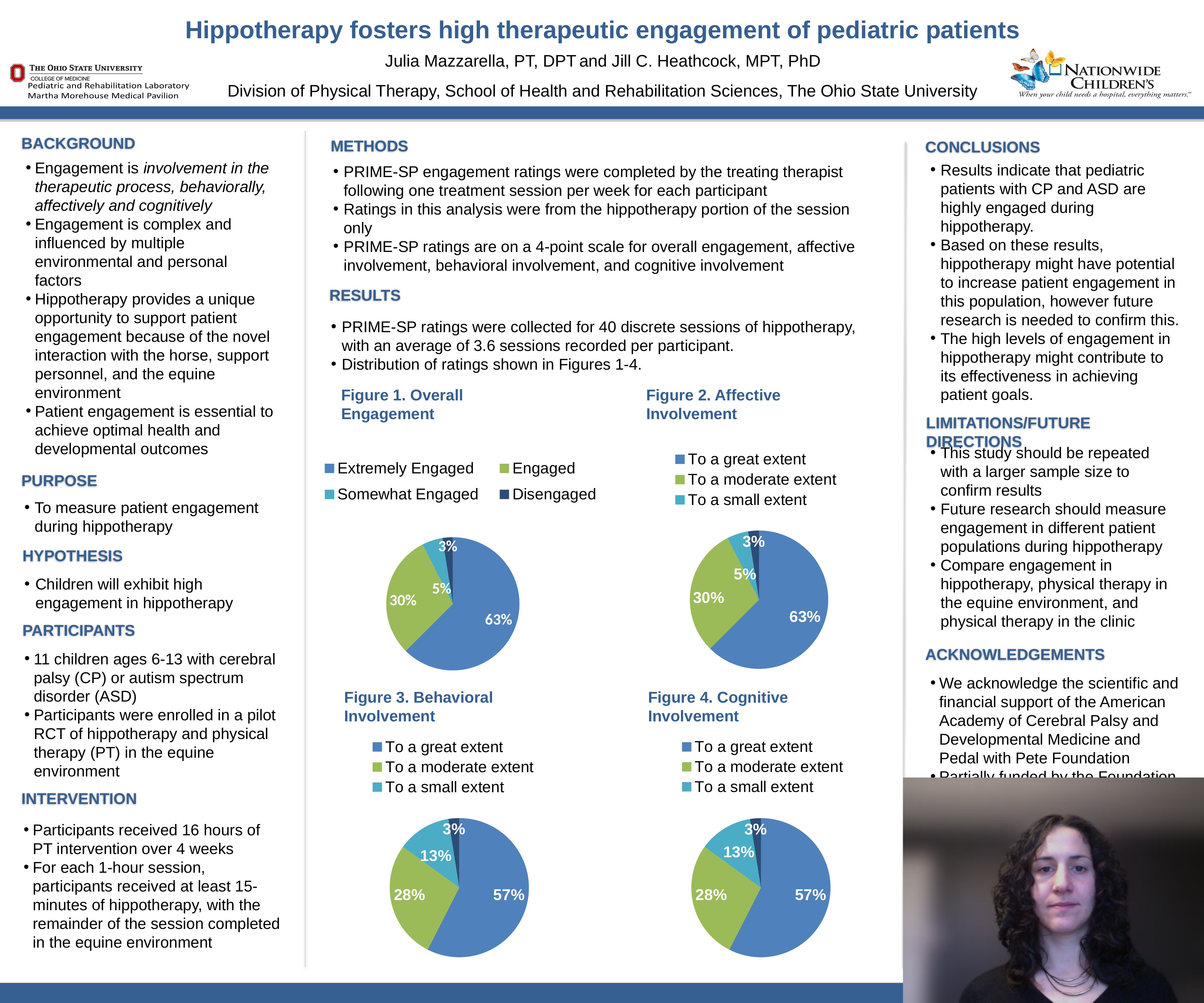
In Figure 1. Overall Engagement, which rating category has the smallest share of the pie? Disengaged In Figure 2. Affective Involvement, what percentage of sessions were rated 'To a great extent'? 63% In Figure 1. Overall Engagement, which rating category has the largest share of the pie? Extremely Engaged How many entries does the legend of Figure 1. Overall Engagement list? 4 In Figure 1. Overall Engagement, what percentage of sessions were rated Somewhat Engaged? 5% What type of chart is used in Figure 1. Overall Engagement? Pie chart In Figure 3. Behavioral Involvement, what is the difference in percentage points between 'To a great extent' and 'To a moderate extent'? 29 percentage points In Figure 3. Behavioral Involvement, what percentage of sessions were rated 'To a small extent'? 13% In Figure 1. Overall Engagement, what percentage of sessions were rated Engaged? 30% In Figure 4. Cognitive Involvement, what percentage of sessions were rated 'To a moderate extent'? 28% In Figure 1. Overall Engagement, what percentage of sessions were rated Extremely Engaged? 63% In Figure 1. Overall Engagement, what percentage of sessions were rated Disengaged? 3%